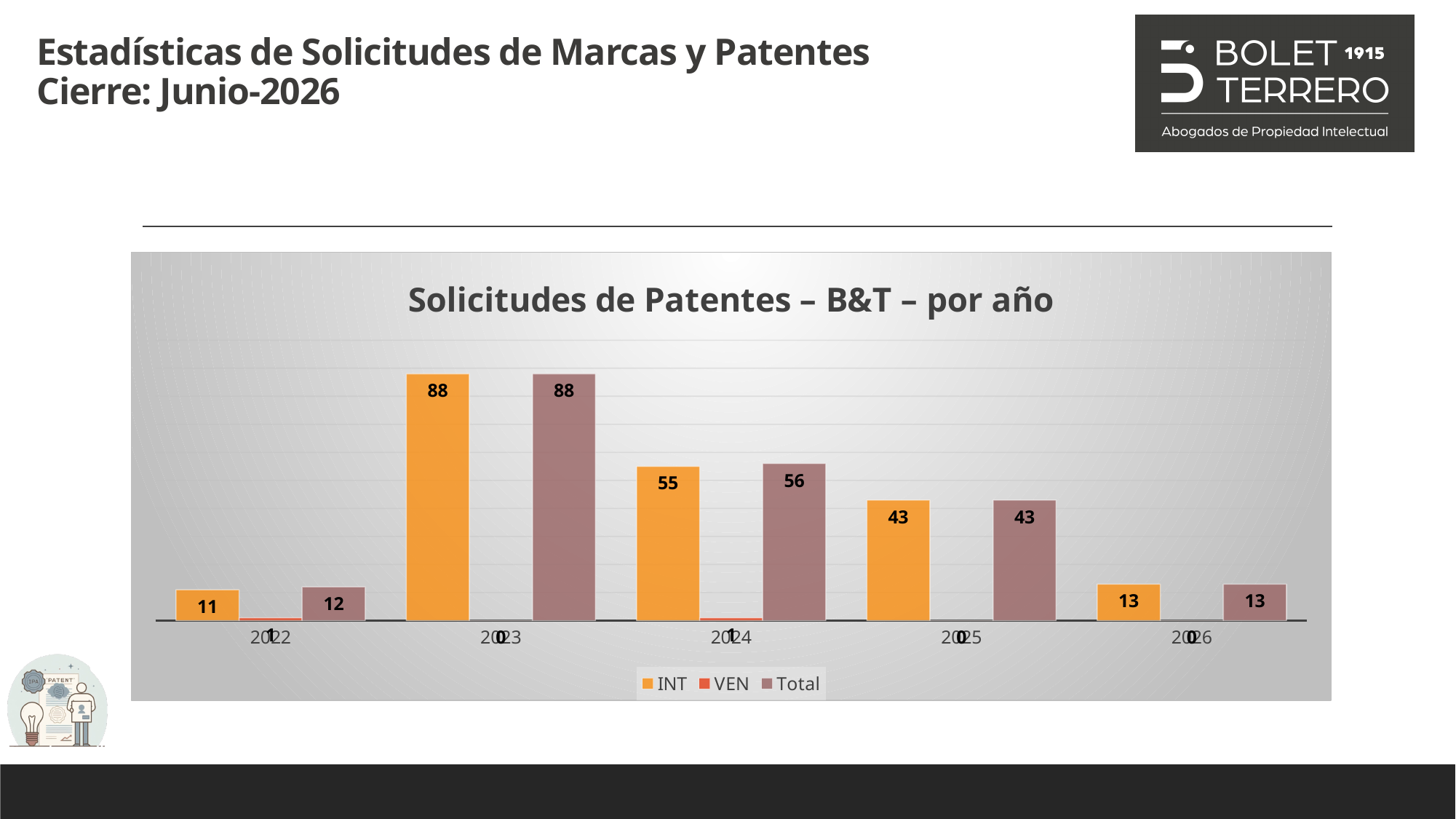
What kind of chart is shown? Bar chart Which year has the lowest Total value? 2022 What is the difference between the Total and INT values for 2022? 1 What is the Total value for 2024? 56 How many series does the legend list? 3 What is the INT value for 2023? 88 What is the title of the chart? Solicitudes de Patentes – B&T – por año What is the difference between the INT values for 2023 and 2024? 33 Which is larger, the INT value for 2025 or the INT value for 2026? 2025 Which year has the highest INT value? 2023 What is the Total value for 2022? 12 What is the INT value for 2026? 13